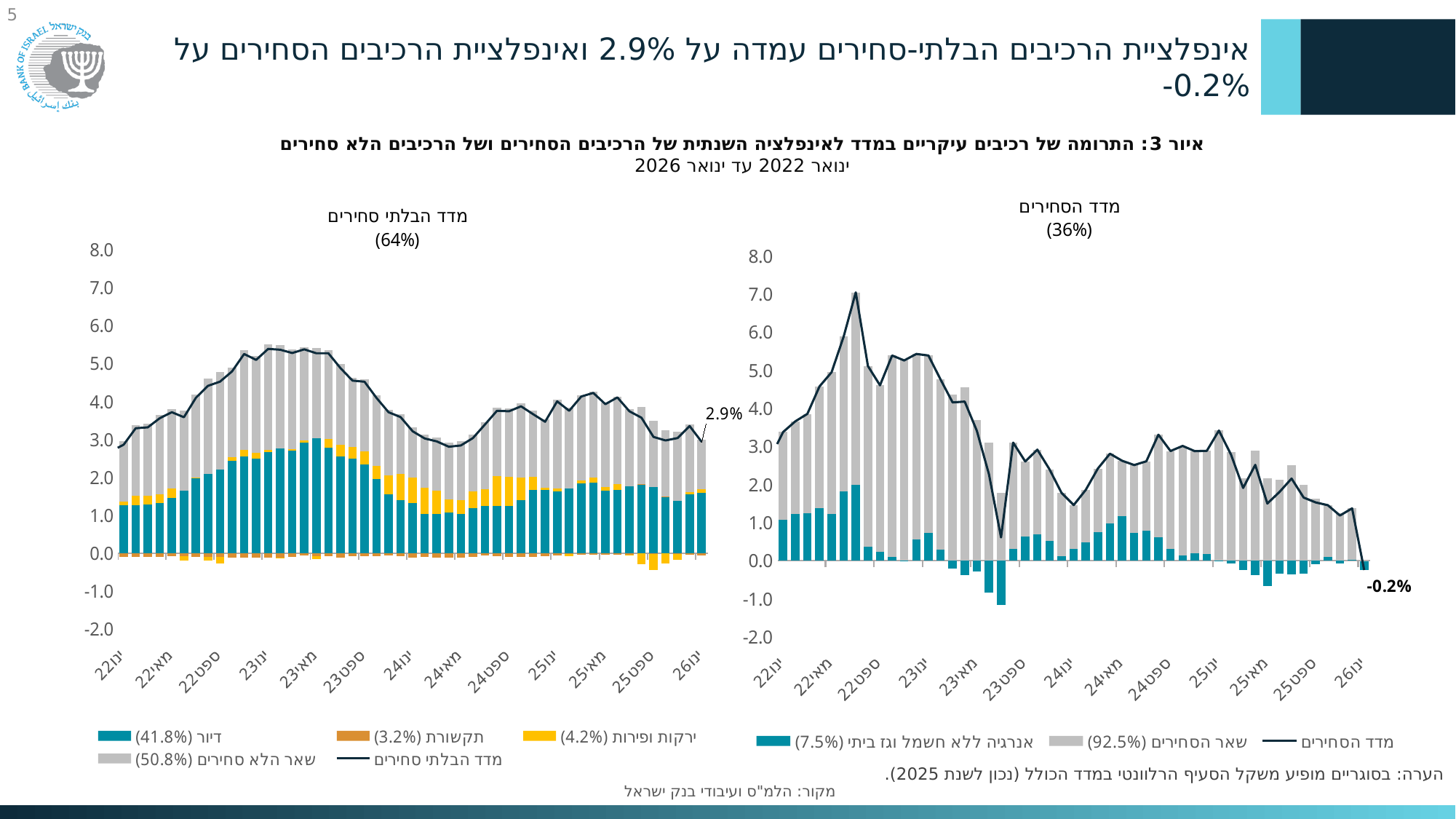
How many entries does the legend of the right chart (מדד הסחירים) list? 3 What kind of chart is used on this slide? Stacked bar charts with a line overlay In the left chart (מדד הבלתי סחירים), what value is labelled at the end of the line for January 2026? 2.9% According to the left chart's legend, what weight is shown for דיור (housing)? 41.8% What is the difference between the labelled January 2026 values of the non-tradable index (2.9%) and the tradable index (-0.2%)? 3.1 percentage points At January 2026, which index is higher: the non-tradable index (left chart) or the tradable index (right chart)? The non-tradable index (2.9%) How many entries does the legend of the left chart (מדד הבלתי סחירים) list? 5 In the right chart (מדד הסחירים), is the peak value of the line in 2022 greater or less than 6.0? greater Which chart reaches a higher peak value on its line: the left (non-tradable) or the right (tradable)? The right chart (tradable index) In the right chart (מדד הסחירים), does the line rise or fall between January 2025 and January 2026? It falls In the left chart (מדד הבלתי סחירים), is the value of the line at January 2022 greater or less than 4.0? less In the right chart (מדד הסחירים), what value is labelled at the end of the line for January 2026? -0.2%